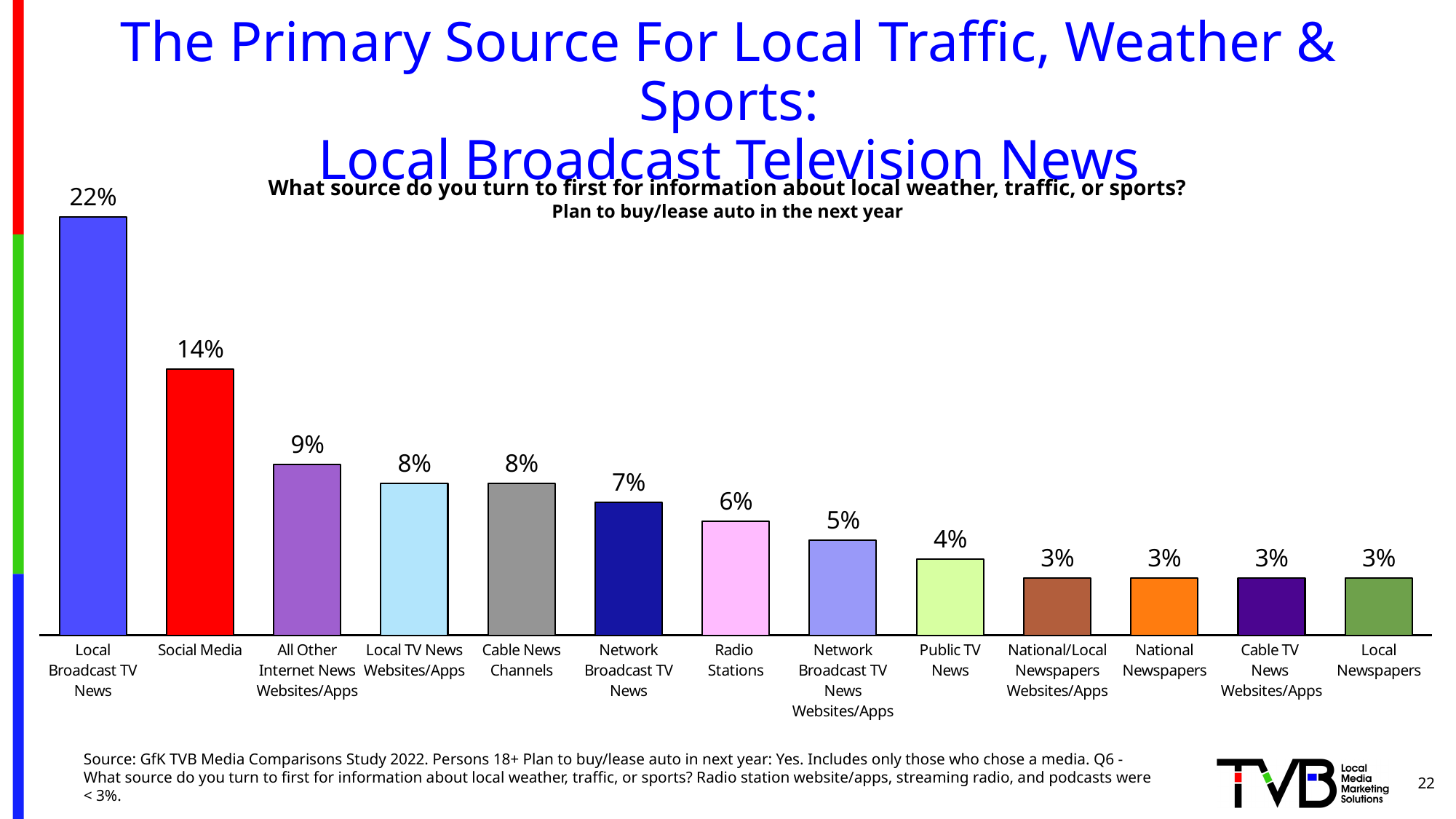
What is the difference between All Other Internet News Websites/Apps and Network Broadcast TV News? 2% What question is the chart based on, as stated in the subtitle? What source do you turn to first for information about local weather, traffic, or sports? What is the value for Local Broadcast TV News? 22% What is the value for Radio Stations? 6% Which is larger, Cable News Channels or Network Broadcast TV News Websites/Apps? Cable News Channels Which source has the highest value? Local Broadcast TV News What is the value for Social Media? 14% How many sources (categories) are shown in the chart? 13 What is the value for Public TV News? 4% What is the difference between Local Broadcast TV News and Social Media? 8% Do the values rise or fall moving from left to right along the x axis? Fall What kind of chart is shown on the slide? Bar chart